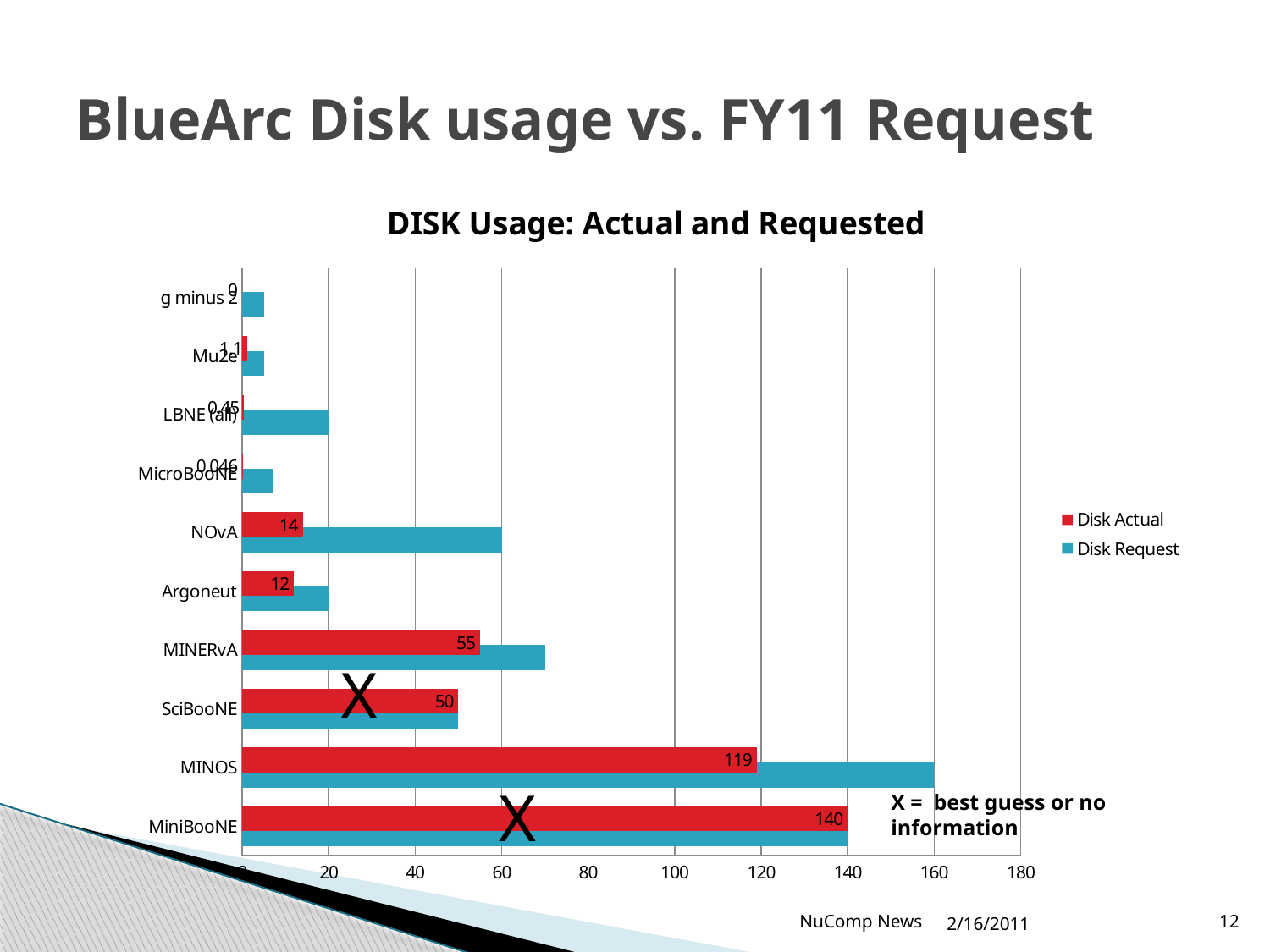
Which experiment has the highest Disk Actual value? MiniBooNE What is the Disk Actual value for MINOS? 119 How many series does the legend list? 2 How many experiments are listed on the chart? 10 Is the Disk Request value for MINERvA greater or less than 60? greater Is the Disk Request value for MINOS greater or less than 140? greater What is the Disk Actual value for MiniBooNE? 140 Which has the larger Disk Actual value, NOvA or Argoneut? NOvA What is the difference between the Disk Actual values for MiniBooNE and MINOS? 21 Which experiment has the lowest Disk Actual value? g minus 2 What is the difference between the Disk Actual values for MINERvA and SciBooNE? 5 What is the Disk Actual value for Mu2e? 1.1